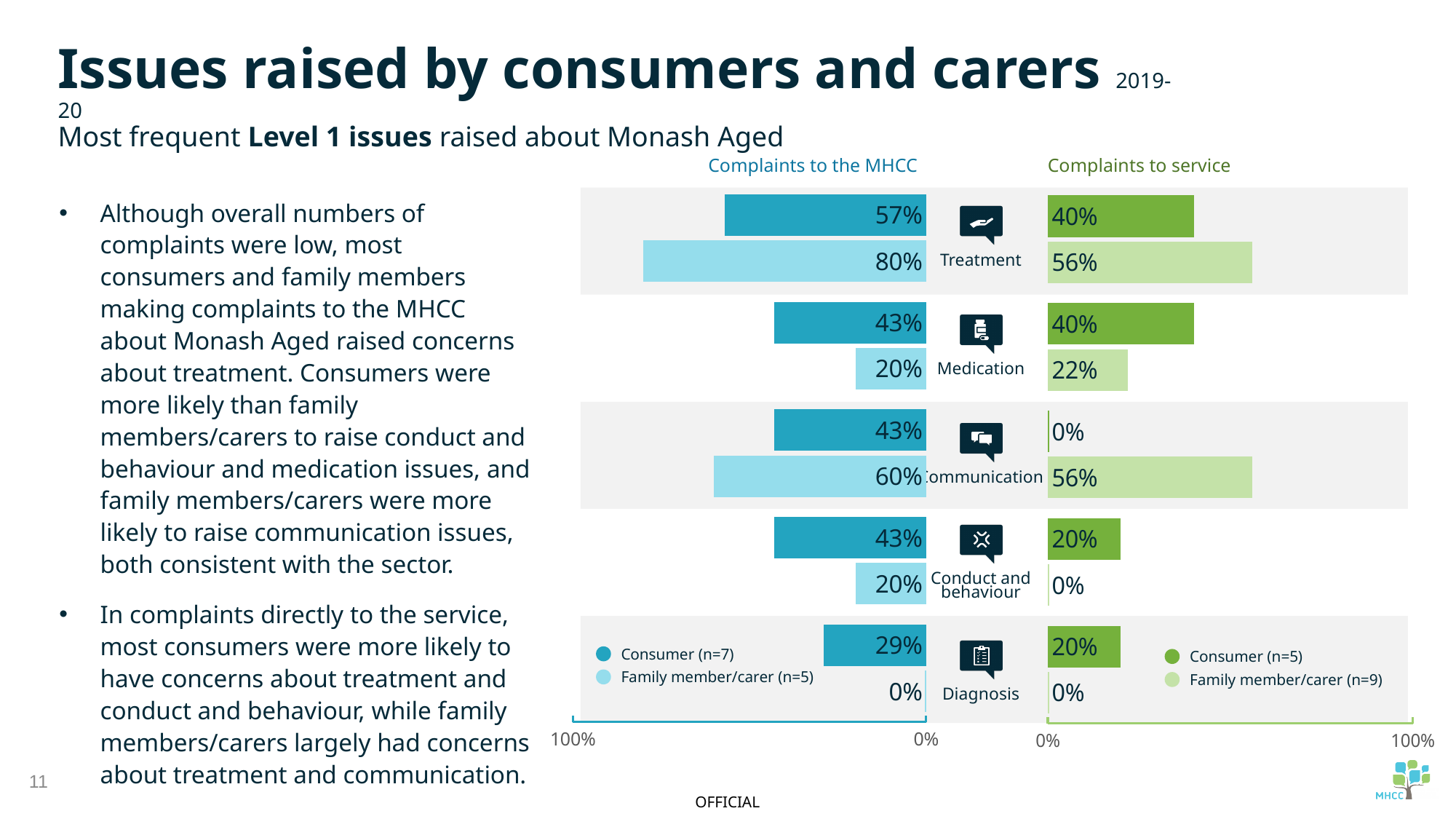
In the 'Complaints to the MHCC' chart, what is the difference between the family member/carer and consumer values for treatment? 23% In the 'Complaints to service' chart, what is the difference between the consumer and family member/carer values for medication? 18% In the 'Complaints to the MHCC' chart, which issue has the lowest value for consumers? Diagnosis In the 'Complaints to the MHCC' chart, what percentage of consumers raised issues about treatment? 57% In the 'Complaints to service' chart, what percentage of family members/carers raised issues about communication? 56% How many series does the legend of the 'Complaints to service' chart list? 2 In the 'Complaints to service' chart, what percentage of consumers raised issues about communication? 0% In the 'Complaints to the MHCC' chart, which issue has the highest value for family members/carers? Treatment In the 'Complaints to the MHCC' chart, which is larger for communication: the consumer value or the family member/carer value? Family member/carer How many issue categories are shown in the charts? 5 What type of chart is used to show the complaints data? Bar chart In the 'Complaints to the MHCC' chart, what percentage of family members/carers raised issues about treatment? 80%